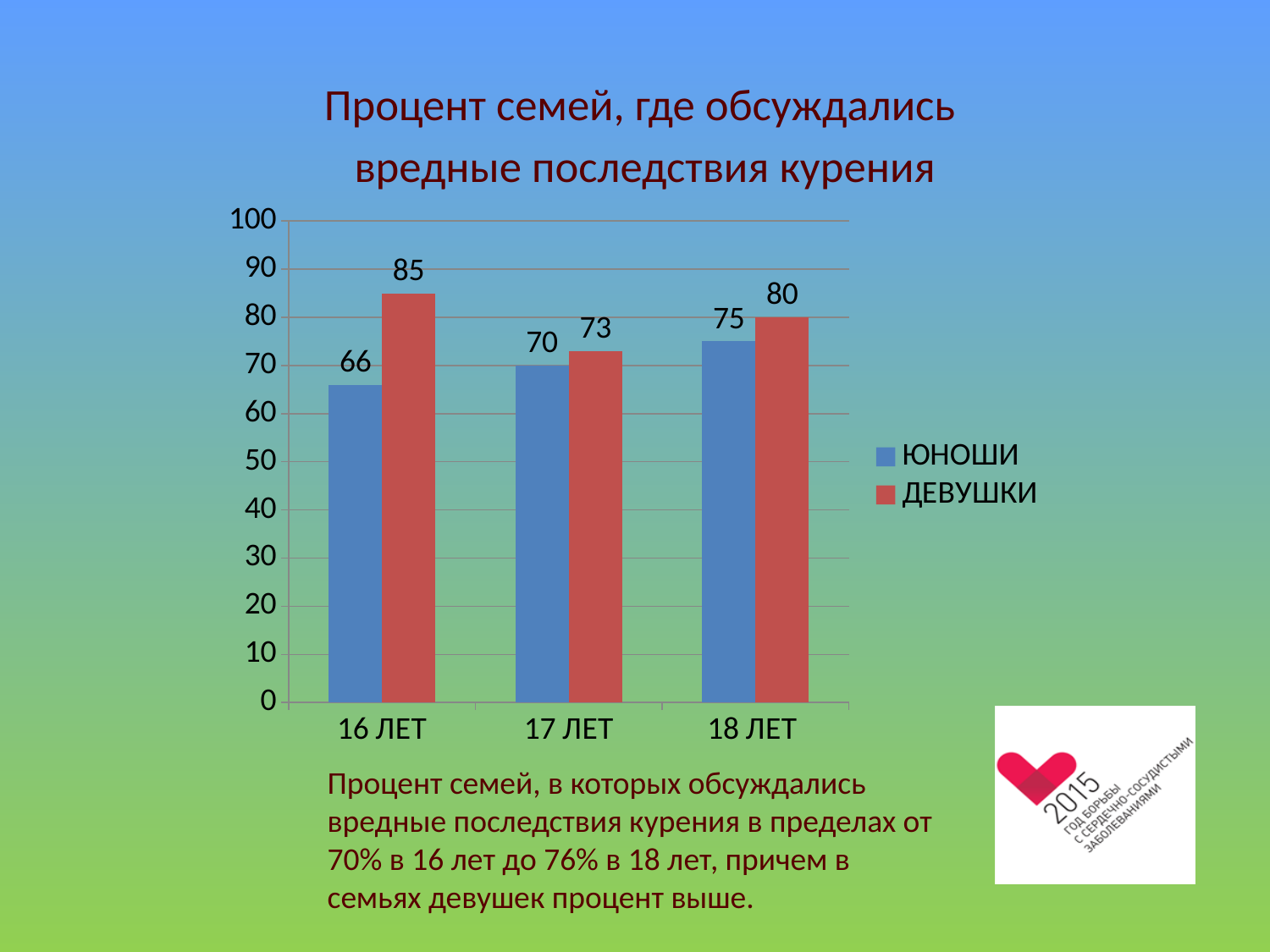
Which is larger at 18 ЛЕТ, ЮНОШИ or ДЕВУШКИ? ДЕВУШКИ What is the value for ЮНОШИ at 16 ЛЕТ? 66 Which age group has the lowest value for ЮНОШИ? 16 ЛЕТ How many series does the legend list? 2 Is the value for ЮНОШИ at 17 ЛЕТ greater or less than 60? greater What is the value for ДЕВУШКИ at 17 ЛЕТ? 73 What is the difference between ДЕВУШКИ and ЮНОШИ at 16 ЛЕТ? 19 Which age group has the highest value for ДЕВУШКИ? 16 ЛЕТ Do the values for ЮНОШИ rise or fall from 16 ЛЕТ to 18 ЛЕТ? rise What is the value for ДЕВУШКИ at 18 ЛЕТ? 80 What kind of chart is shown on the slide? bar chart How many age categories are shown on the x axis? 3